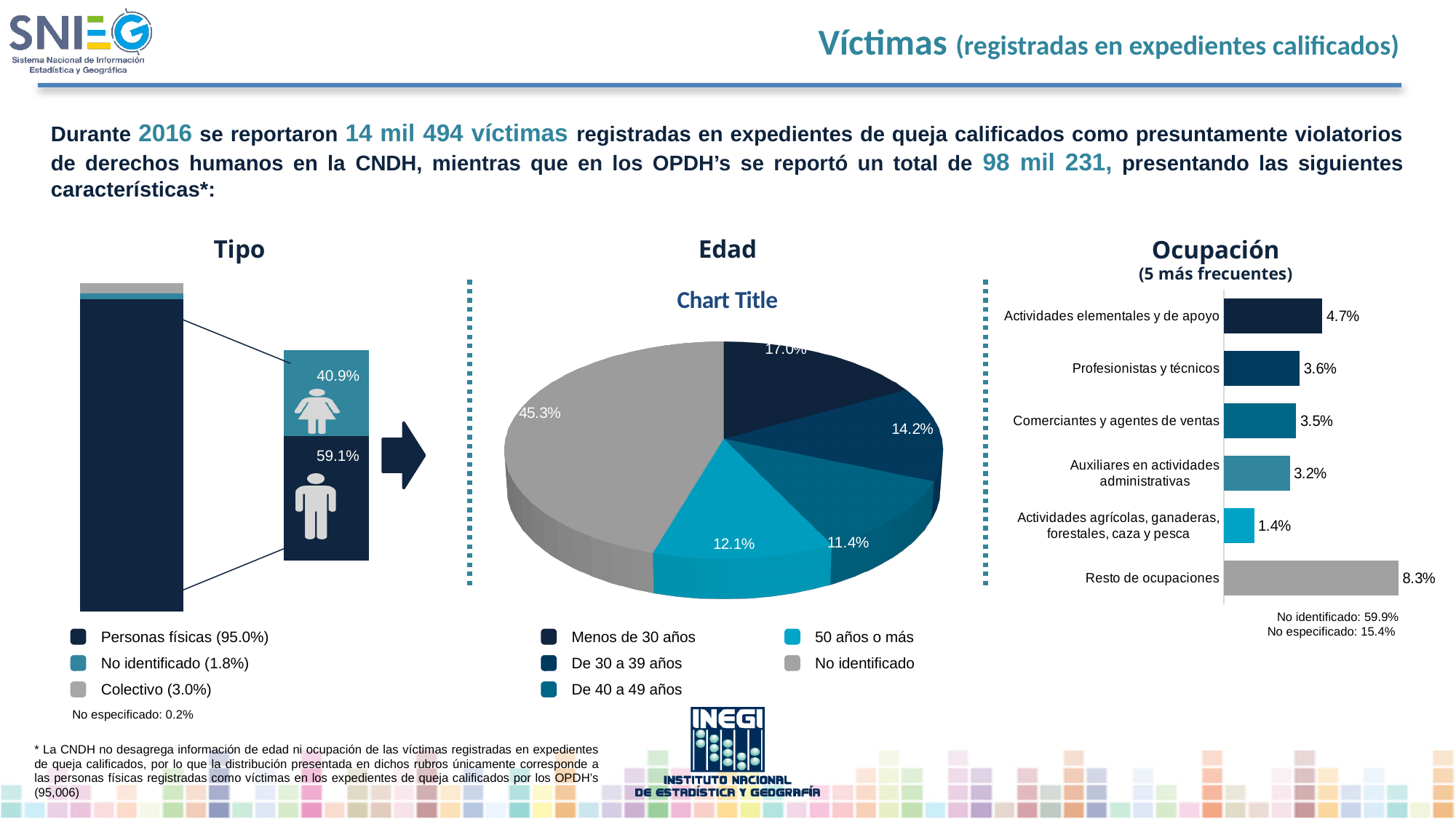
What kind of chart is the Ocupación chart? Bar chart In the Edad pie chart, what share does No identificado have? 45.3% In the Ocupación chart, what is the value for Profesionistas y técnicos? 3.6% In the Edad pie chart, which is larger: 50 años o más or De 40 a 49 años? 50 años o más In the Ocupación chart, what is the value for Actividades agrícolas, ganaderas, forestales, caza y pesca? 1.4% In the Tipo chart, what percentage corresponds to Personas físicas? 95.0% In the Ocupación chart, how many bars are plotted? 6 In the Edad pie chart, what is the value for De 30 a 39 años? 14.2% In the Ocupación chart, what is the difference between Resto de ocupaciones and Actividades elementales y de apoyo? 3.6% In the Ocupación chart, which category has the lowest value? Actividades agrícolas, ganaderas, forestales, caza y pesca In the Ocupación chart, which of the five most frequent occupations has the highest value? Actividades elementales y de apoyo How many entries does the legend of the Edad pie chart list? 5